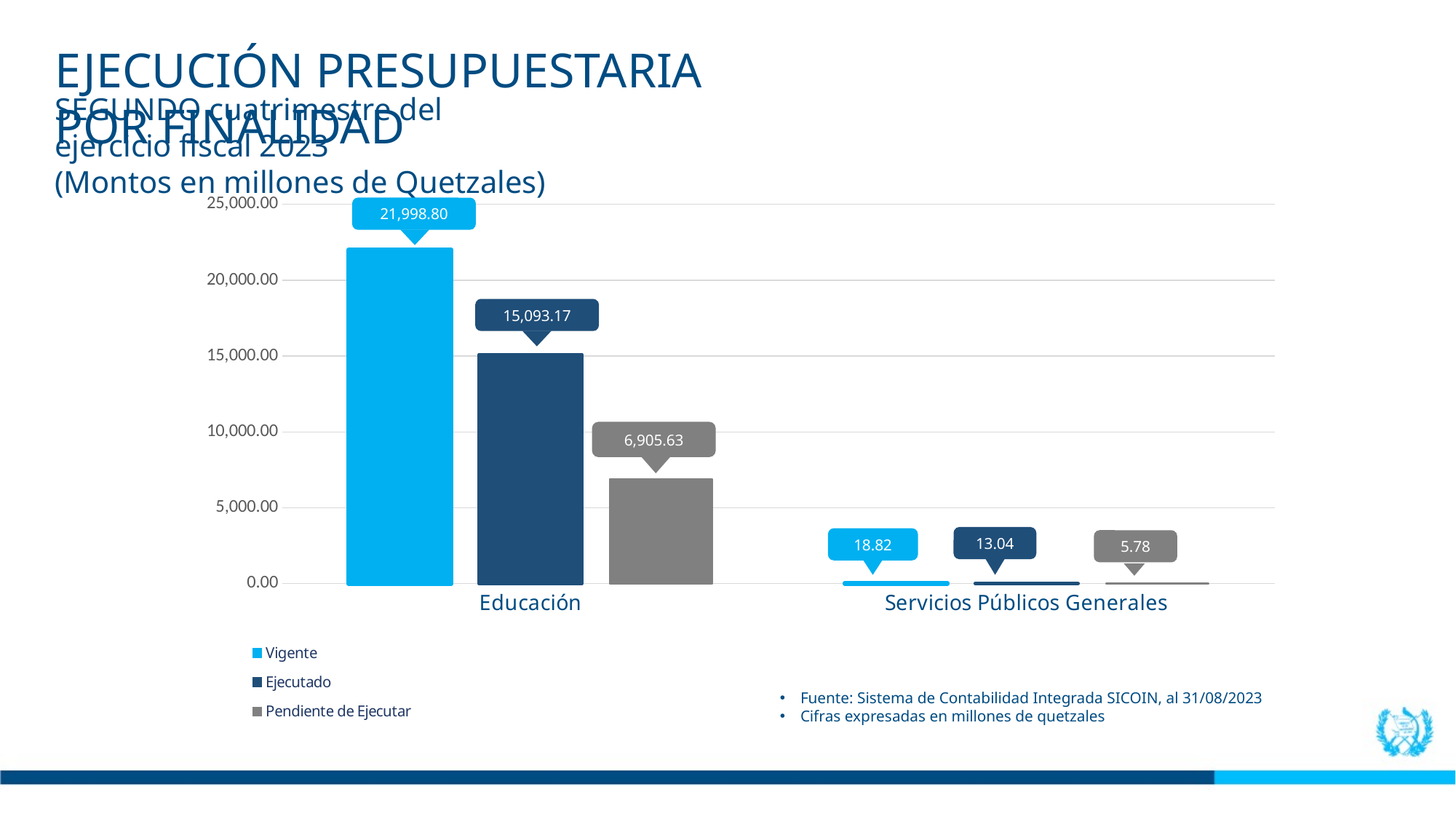
Which series has the lowest value for Servicios Públicos Generales? Pendiente de Ejecutar What is the Vigente value for Servicios Públicos Generales? 18.82 What is the Pendiente de Ejecutar value for Servicios Públicos Generales? 5.78 What is the difference between the Vigente and Ejecutado values for Educación? 6,905.63 What is the Ejecutado value for Educación? 15,093.17 How many categories are shown on the x axis? 2 How many series does the legend list? 3 Which category has the highest Ejecutado value? Educación Which is larger for Servicios Públicos Generales: Vigente or Ejecutado? Vigente What is the difference between the Ejecutado and Pendiente de Ejecutar values for Educación? 8,187.54 What is the Vigente value for Educación? 21,998.80 What kind of chart is shown on the slide? Bar chart